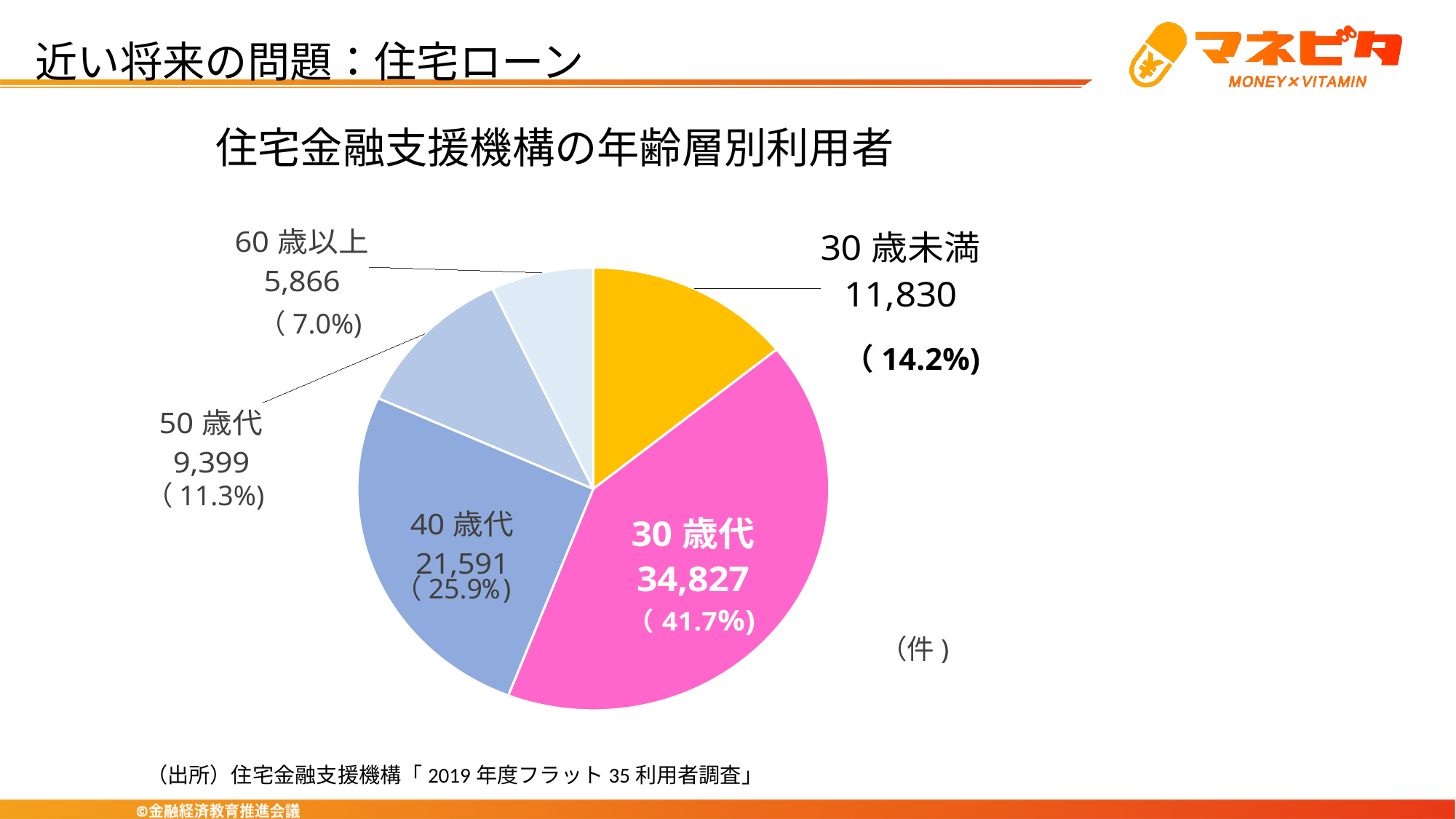
What kind of chart is shown on the slide? pie chart What is the value for 60歳以上? 5,866 What is the value for 30歳代? 34,827 What is the value for 30歳未満? 11,830 Which is larger, the value for 30歳未満 or the value for 50歳代? 30歳未満 Which age group has the smallest share of the pie? 60歳以上 What share of the pie does 50歳代 represent? 11.3% How many age categories does the pie chart show? 5 What is the value for 40歳代? 21,591 What is the difference between the values for 30歳代 and 40歳代? 13,236 Which age group has the largest share of the pie? 30歳代 What is the title of the chart? 住宅金融支援機構の年齢層別利用者